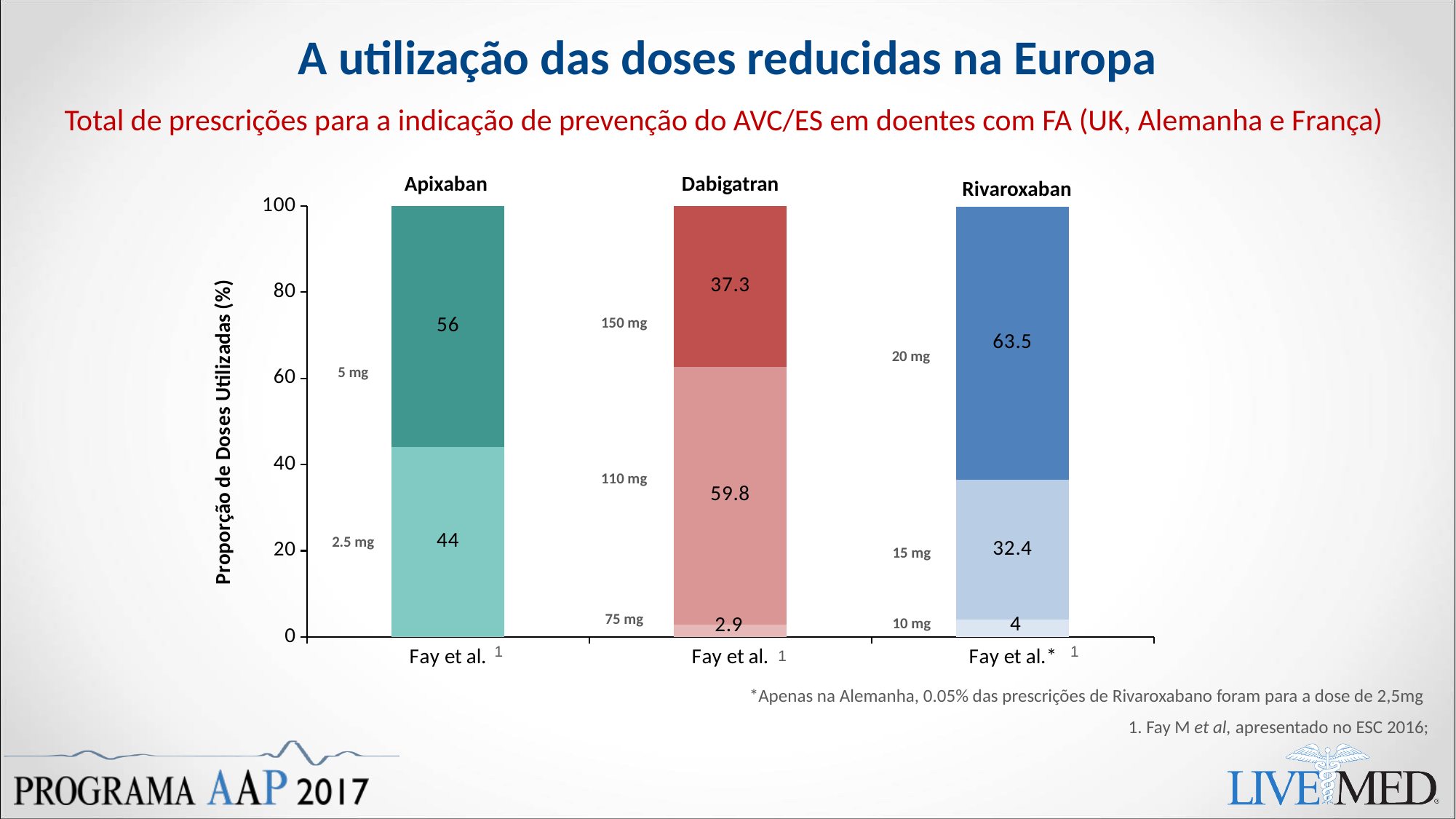
What is the difference between the 20 mg and 15 mg shares for Rivaroxaban? 31.1 How many drugs (bars) are shown in the chart? 3 Which Dabigatran dose has the largest share of doses used? 110 mg What proportion of Dabigatran doses used were 110 mg? 59.8 Which is larger: the 150 mg share for Dabigatran or the 5 mg share for Apixaban? 5 mg share for Apixaban What proportion of Rivaroxaban doses used were 20 mg? 63.5 What proportion of Apixaban doses used were 2.5 mg? 44 What proportion of Dabigatran doses used were 75 mg? 2.9 What proportion of Apixaban doses used were 5 mg? 56 What type of chart is shown on the slide? Stacked bar chart What proportion of Rivaroxaban doses used were 10 mg? 4 Which Rivaroxaban dose has the smallest share of doses used? 10 mg